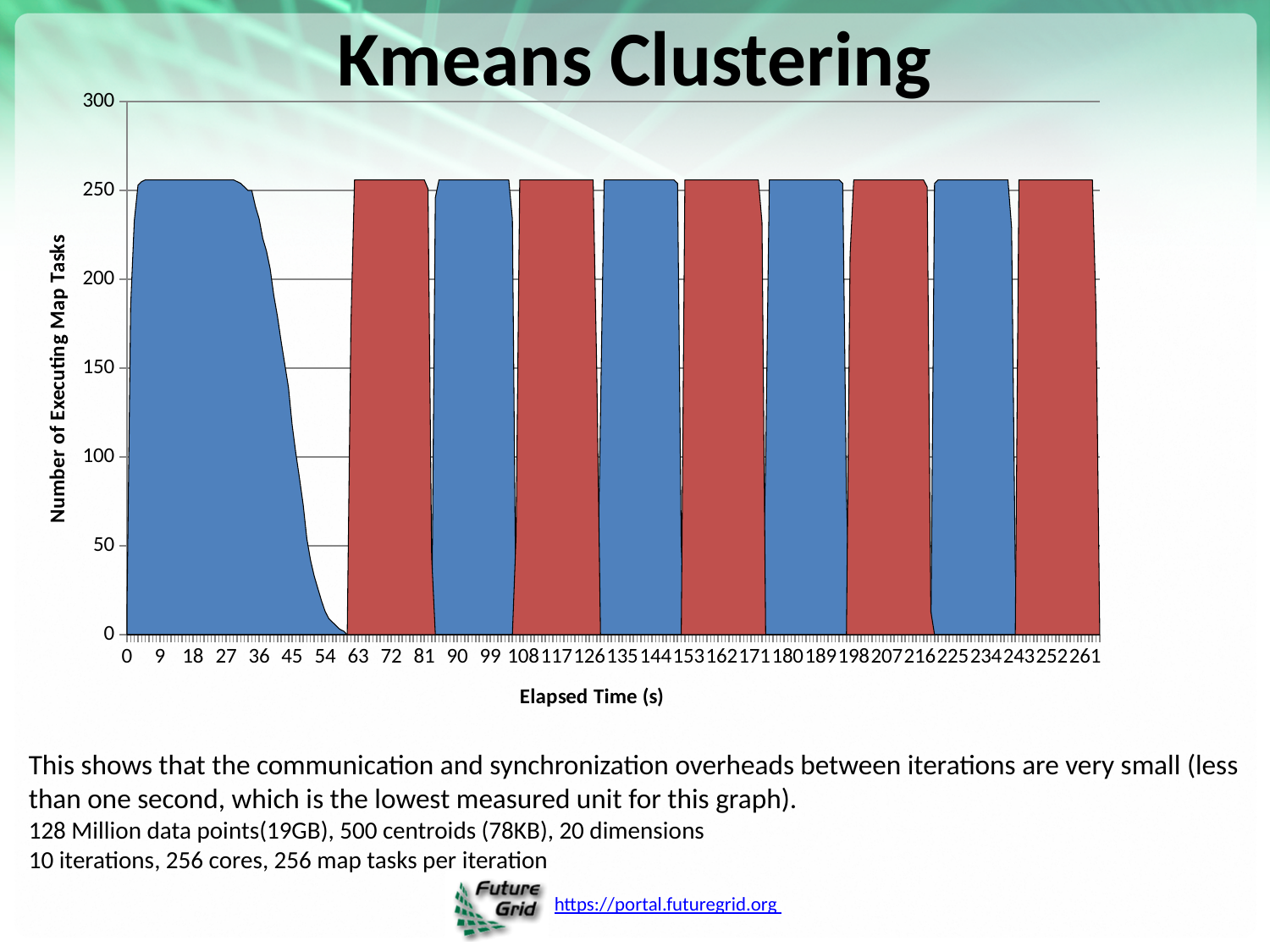
What is the label of the x axis? Elapsed Time (s) What is the title of the chart? Kmeans Clustering Is the number of executing map tasks at 72 s greater or less than 200? greater What is the last tick value shown on the x axis? 261 What kind of chart is shown on the slide? area chart How many separate shaded blocks (iterations) are plotted in the chart? 10 What is the highest value shown on the y axis? 300 Is the number of executing map tasks at 18 s greater or less than 200? greater Is the number of executing map tasks at 9 s greater or less than 150? greater Between 27 s and 58 s, does the number of executing map tasks rise or fall? fall